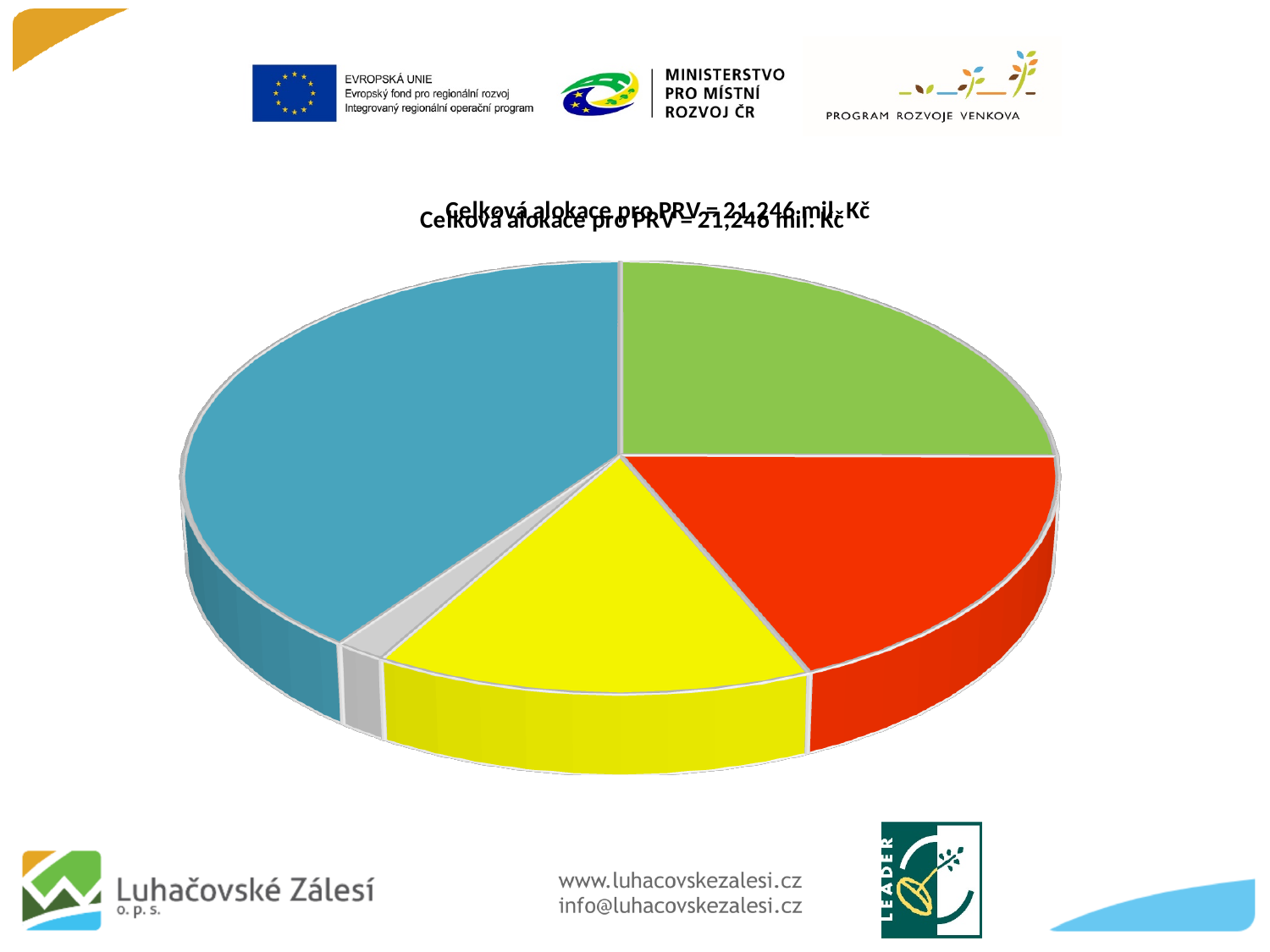
What total allocation for PRV does the chart title state? 21,246 mil. Kč Which colour slice is the largest in the pie chart? blue Which is larger, the blue slice or the red slice? blue Which is larger, the green slice or the yellow slice? green How many slices does the pie chart have? 5 Which is larger, the blue slice or the green slice? blue What is the title of the pie chart? Celková alokace pro PRV = 21,246 mil. Kč What kind of chart is shown on the slide? pie chart